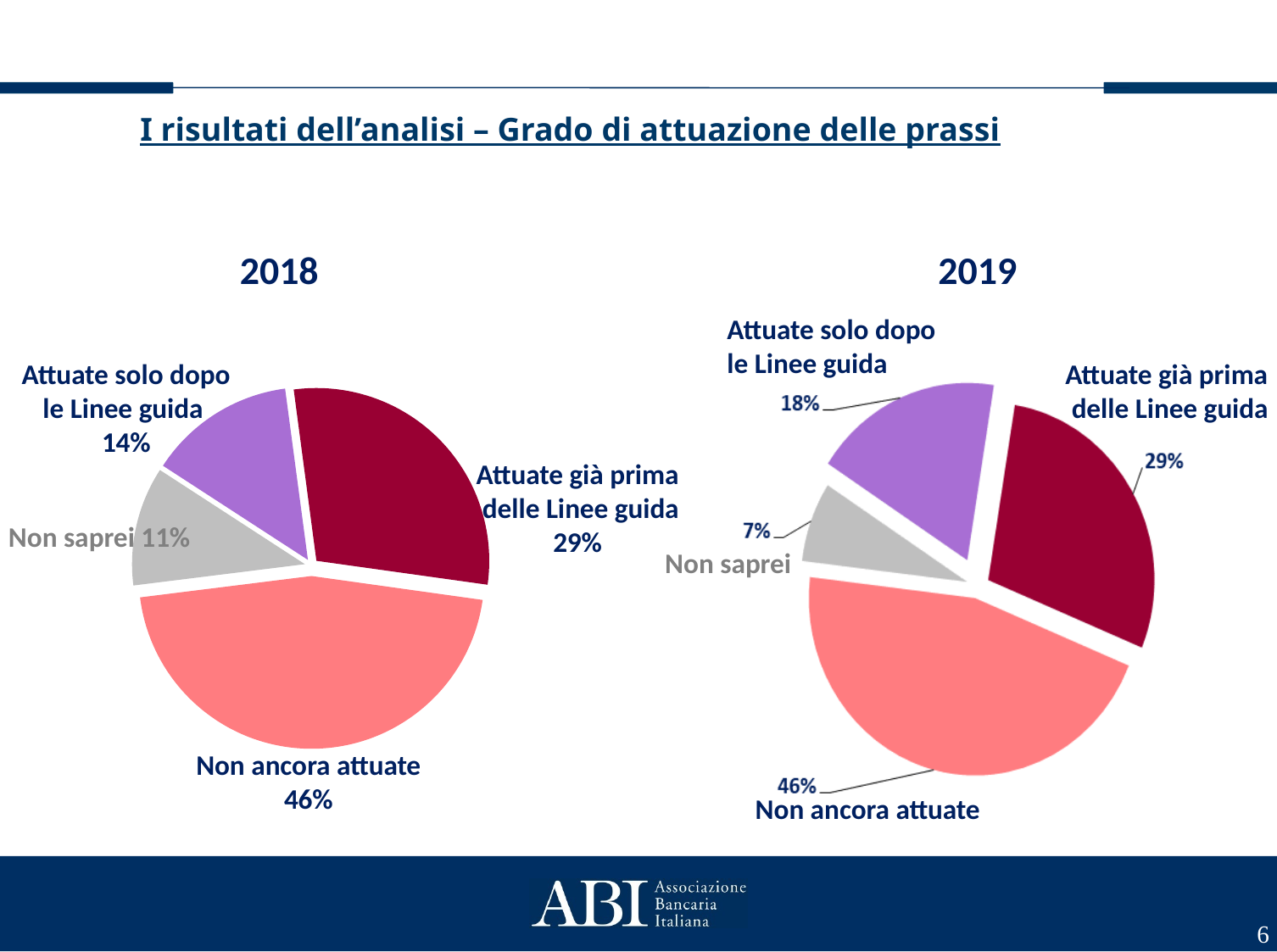
In the 2018 chart, which category has the largest slice? Non ancora attuate In the 2018 chart, what is the difference between "Non ancora attuate" and "Attuate già prima delle Linee guida"? 17 percentage points In the 2019 chart, which category has the smallest slice? Non saprei In the 2018 chart, what share is labelled for "Attuate già prima delle Linee guida"? 29% In the 2019 chart, what share is labelled for "Non saprei"? 7% How many slices does the 2019 chart have? 4 In the 2019 chart, what share is labelled for "Attuate solo dopo le Linee guida"? 18% What is the difference between the "Attuate solo dopo le Linee guida" share in 2019 and in 2018? 4 percentage points In the 2018 chart, what share is labelled for "Non ancora attuate"? 46% What type of chart is used for the 2018 and 2019 data? Pie chart In the 2018 chart, which category has the smallest slice? Non saprei Which is larger: the "Non saprei" share in 2018 or in 2019? 2018